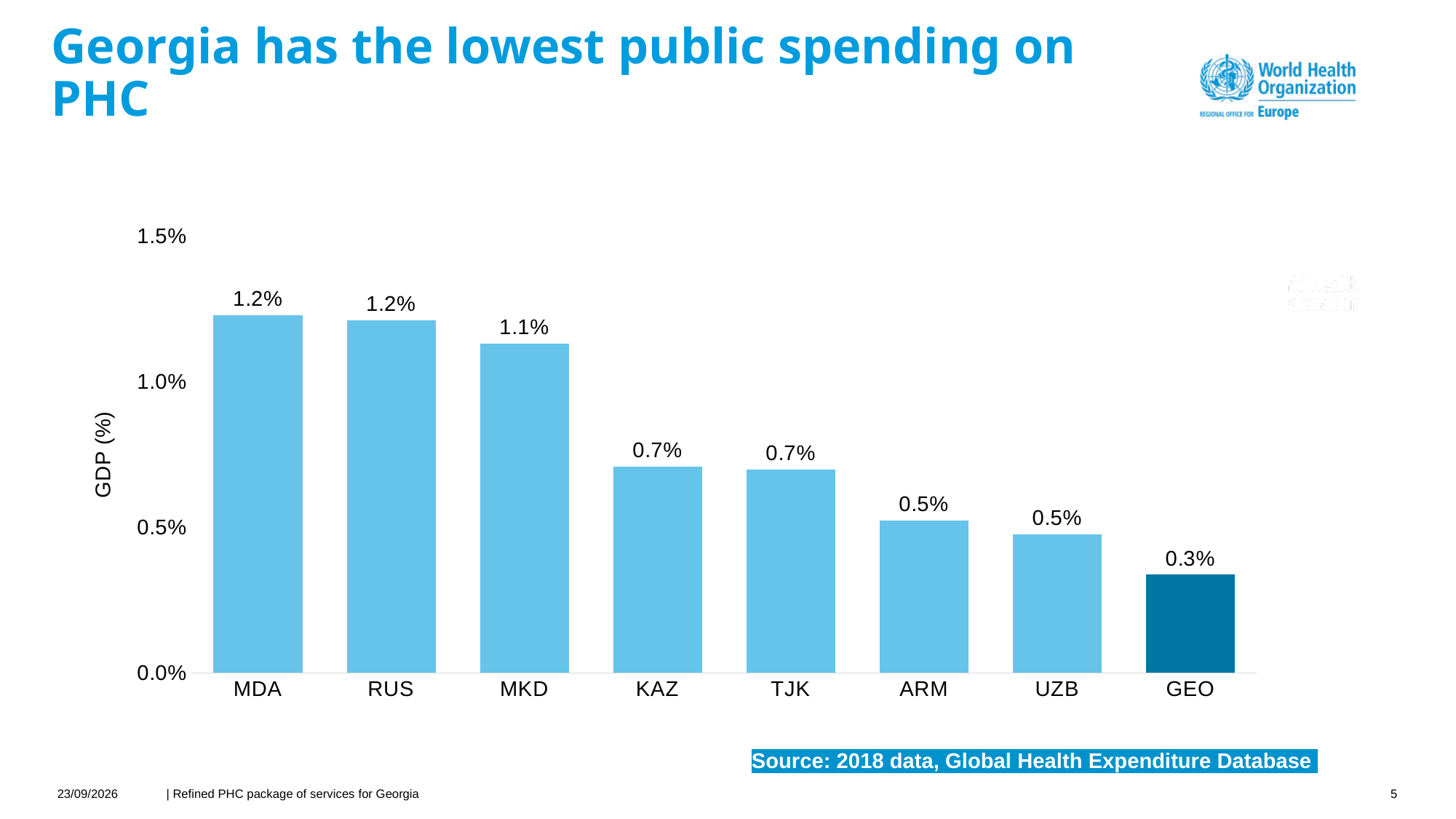
What is the label of the y axis? GDP (%) What kind of chart is shown on the slide? bar chart How many categories are shown on the x axis? 8 What is the value for GEO? 0.3% Which is larger, the value for MKD or the value for KAZ? MKD What is the difference between the values for MKD and GEO? 0.8% What is the value for MKD? 1.1% What is the value for KAZ? 0.7% Which category has the lowest value? GEO Do the values rise or fall from left to right along the x axis? fall Is the value for GEO greater or less than 0.5%? less What is the value for MDA? 1.2%